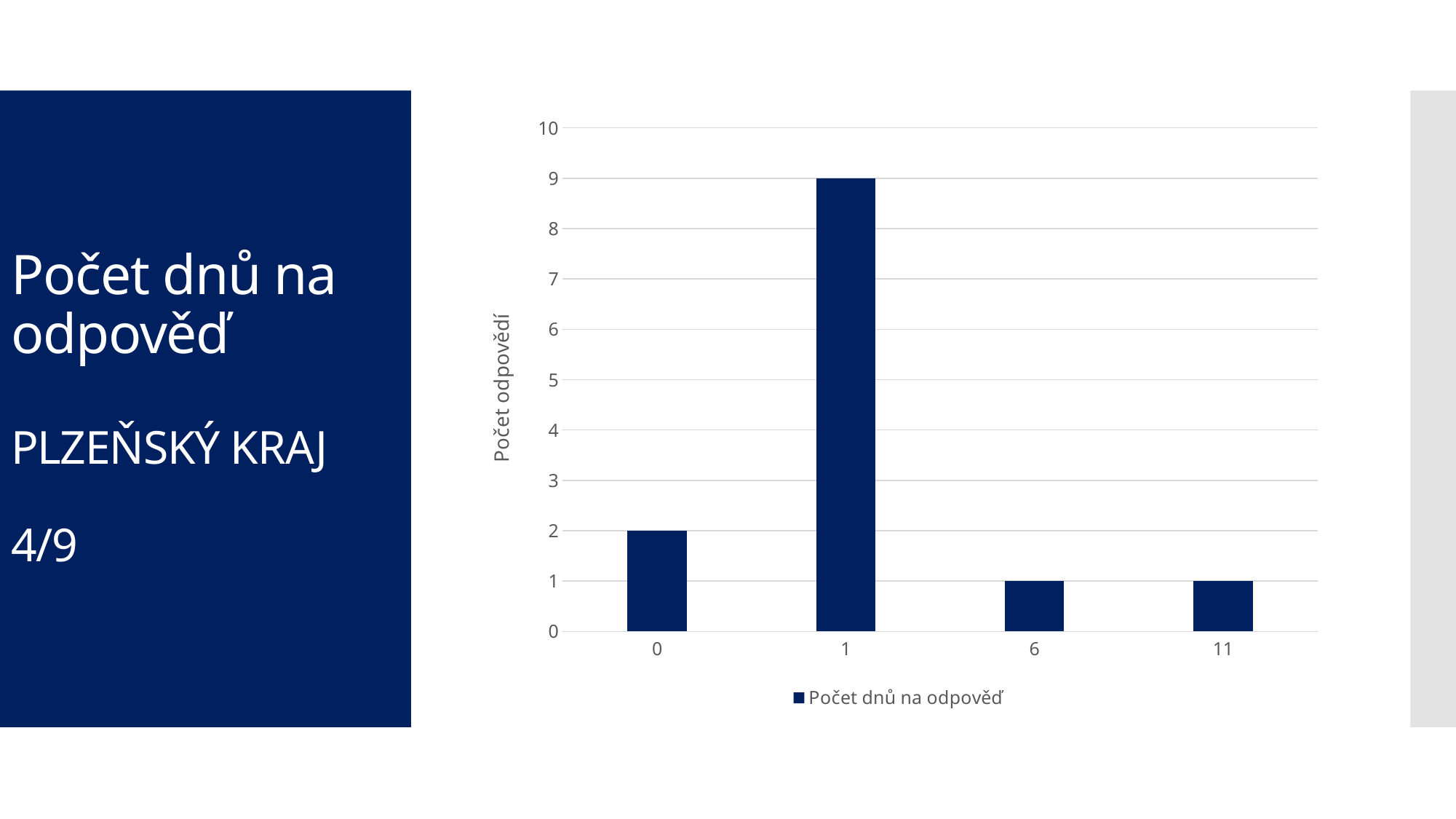
Which category has the highest bar? 1 What is the value of the bar for category 6? 1 Is the value for category 1 greater or less than 5? greater What is the value of the bar for category 0? 2 How many series does the chart legend list? 1 How many categories are shown on the x axis of the chart? 4 What series name is shown in the chart legend? Počet dnů na odpověď Which is larger, the value for category 0 or the value for category 11? category 0 What is the value of the bar for category 1? 9 What type of chart is shown on the slide? bar chart What is the label of the y axis? Počet odpovědí What is the difference between the values for category 1 and category 0? 7